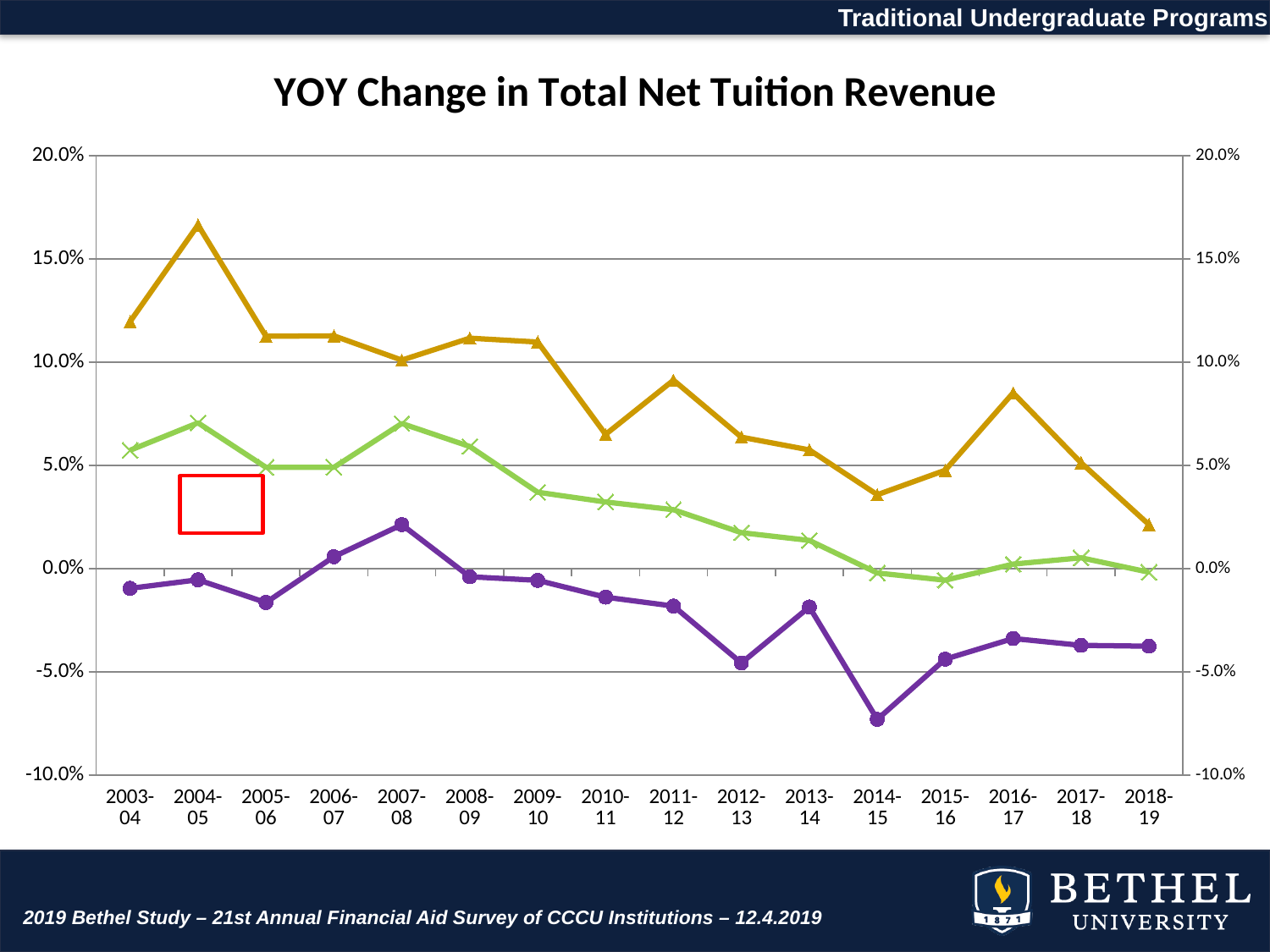
What kind of chart is shown on the slide? line chart Is the value of the gold line for 2004-05 greater or less than 15.0%? greater Does the gold line with triangle markers generally rise or fall from 2003-04 to 2018-19? fall How many data series (lines) are plotted on the chart? 3 What is the title of the chart? YOY Change in Total Net Tuition Revenue Is the value of the purple line for 2014-15 greater or less than -5.0%? less Is the value of the gold line for 2003-04 greater or less than 10.0%? greater How many academic-year categories are shown on the x axis? 16 In which year does the purple line with circle markers reach its lowest value? 2014-15 In which year does the purple line with circle markers reach its highest value? 2007-08 For 2010-11, which is larger: the value of the gold line or the value of the purple line? the gold line In which year does the gold line with triangle markers reach its highest value? 2004-05